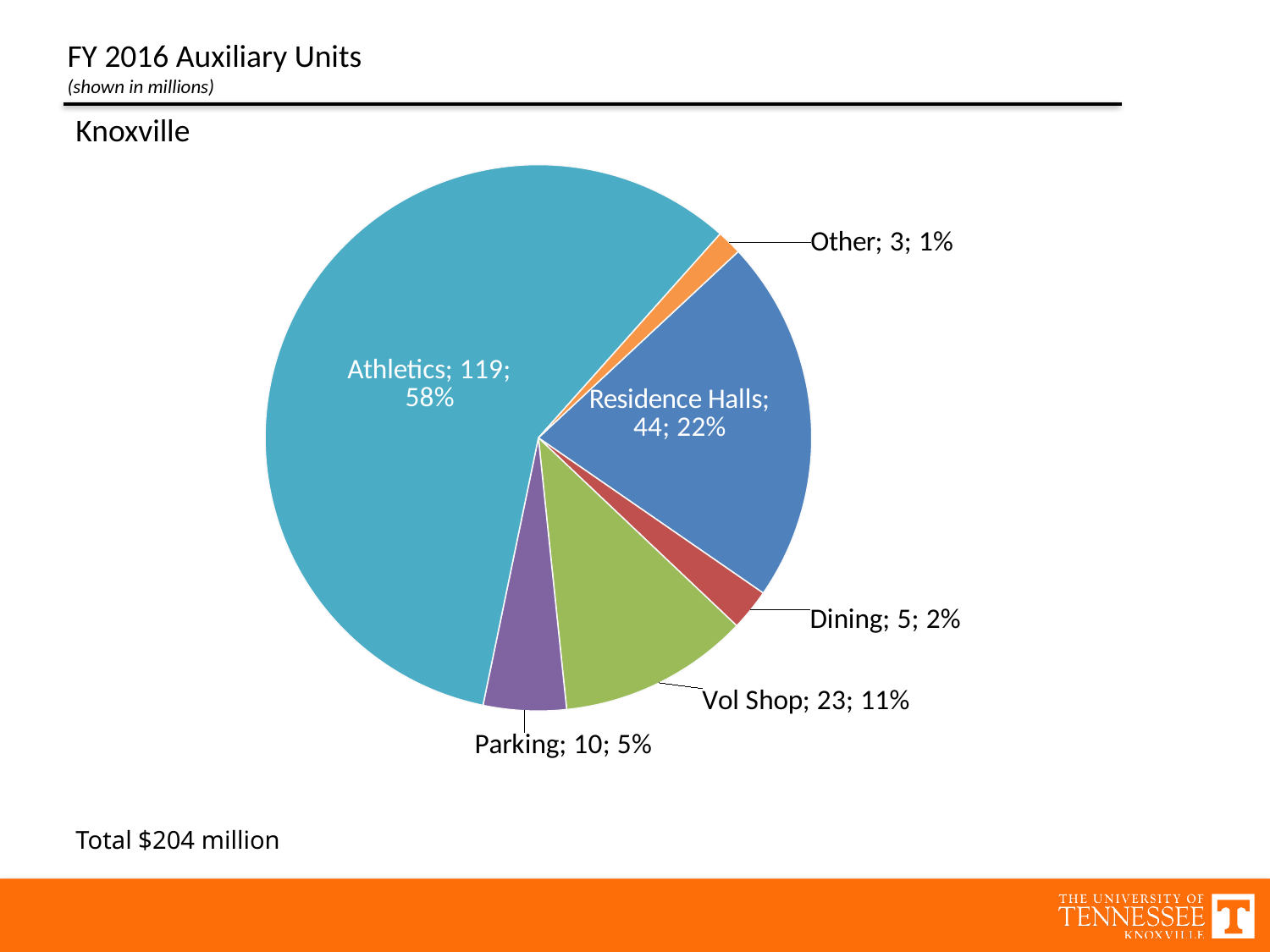
What kind of chart is shown on the slide? pie chart What is the value for Vol Shop? 23 What is the value for Parking? 10 Which category has the smallest slice? Other What is the value for Residence Halls? 44 What is the difference between the values for Athletics and Residence Halls? 75 Which category has the largest slice? Athletics How many categories are shown in the pie chart? 6 What is the value for Athletics? 119 Which is larger, the value for Dining or the value for Parking? Parking What share of the pie does Vol Shop represent? 11% What share of the pie does Residence Halls represent? 22%